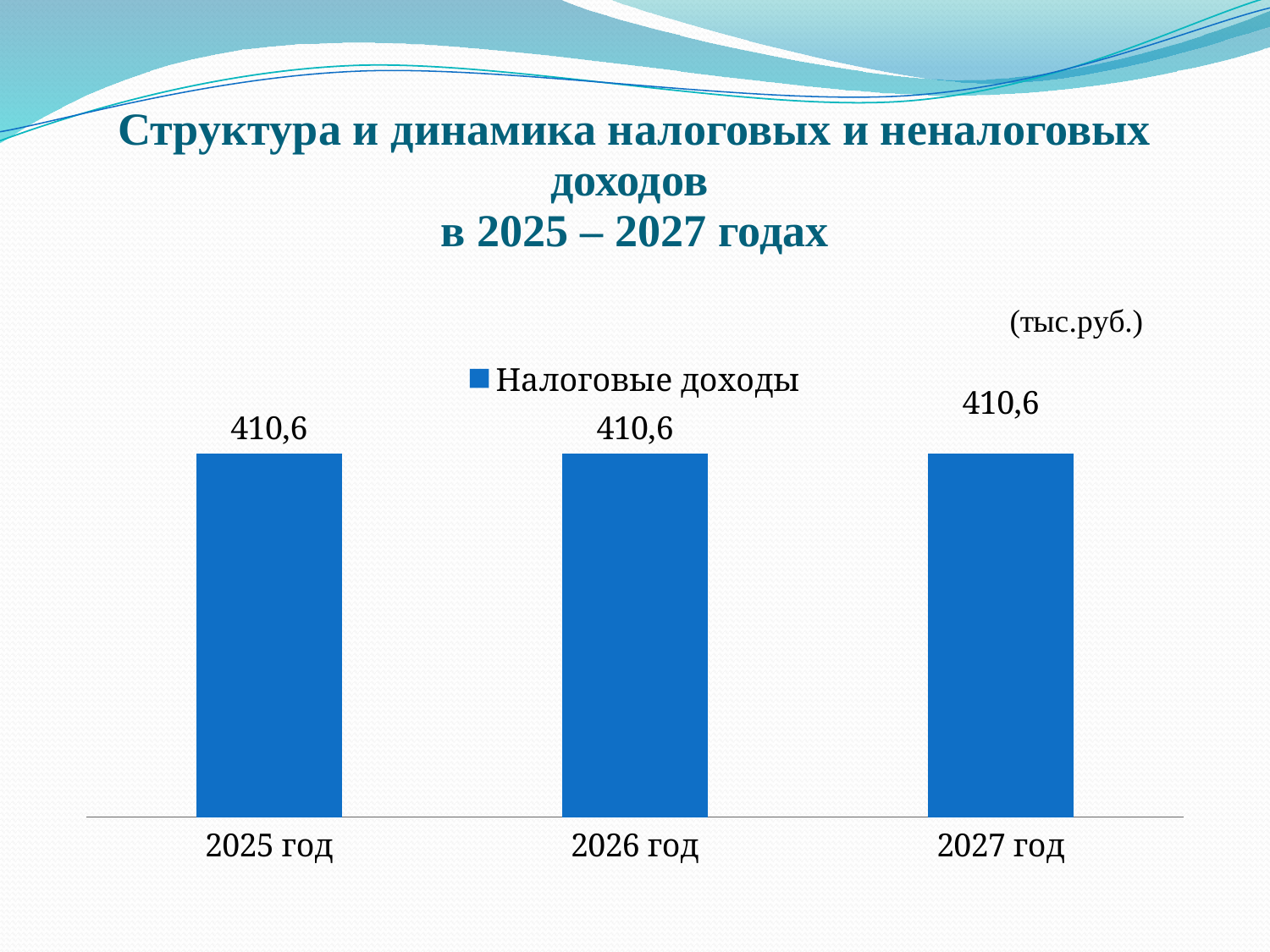
How many categories are shown on the x axis? 3 What is the value for 2025 год? 410,6 What unit is indicated above the chart? тыс.руб. How many series does the legend list? 1 What kind of chart is shown on the slide? bar chart What is the value for 2027 год? 410,6 What is the value for 2026 год? 410,6 What is the difference between the values for 2025 год and 2027 год? 0 What series name is shown in the legend? Налоговые доходы Do the values rise, fall or stay the same from 2025 год to 2027 год? stay the same